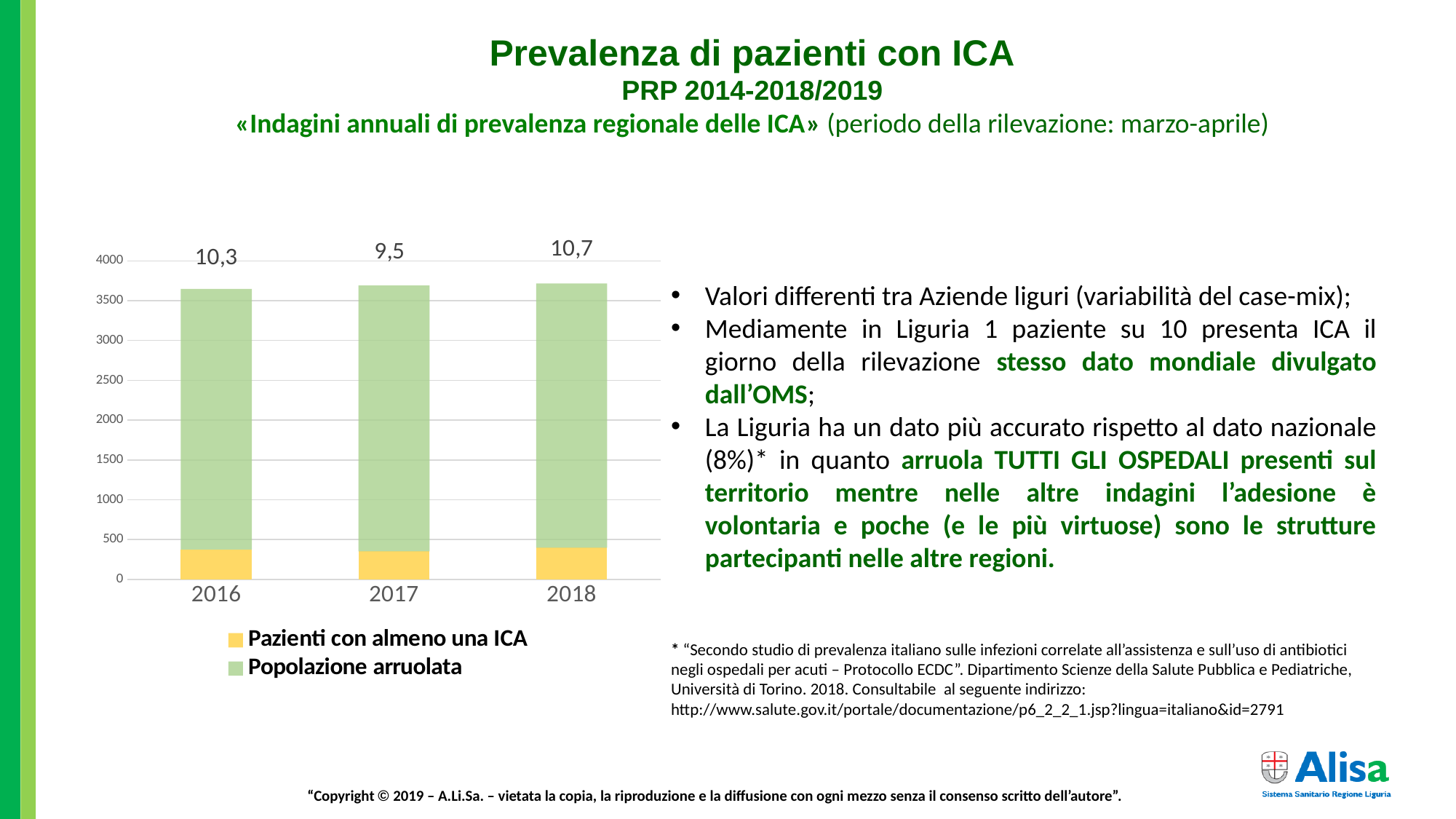
How many years are shown on the x axis of the chart? 3 What value is printed above the bar for 2016? 10,3 Is the total height of the stacked bar for 2016 greater or less than 3500? greater What value is printed above the bar for 2018? 10,7 What is the difference between the values printed above the 2018 and 2017 bars? 1,2 What value is printed above the bar for 2017? 9,5 Which year has the highest value printed above its bar? 2018 How many series does the chart legend list? 2 Which year has the lowest value printed above its bar? 2017 Which colour represents 'Pazienti con almeno una ICA' in the chart? Yellow What kind of chart is shown on the slide? Stacked bar chart Is the 'Pazienti con almeno una ICA' segment for 2016 greater or less than 500? less